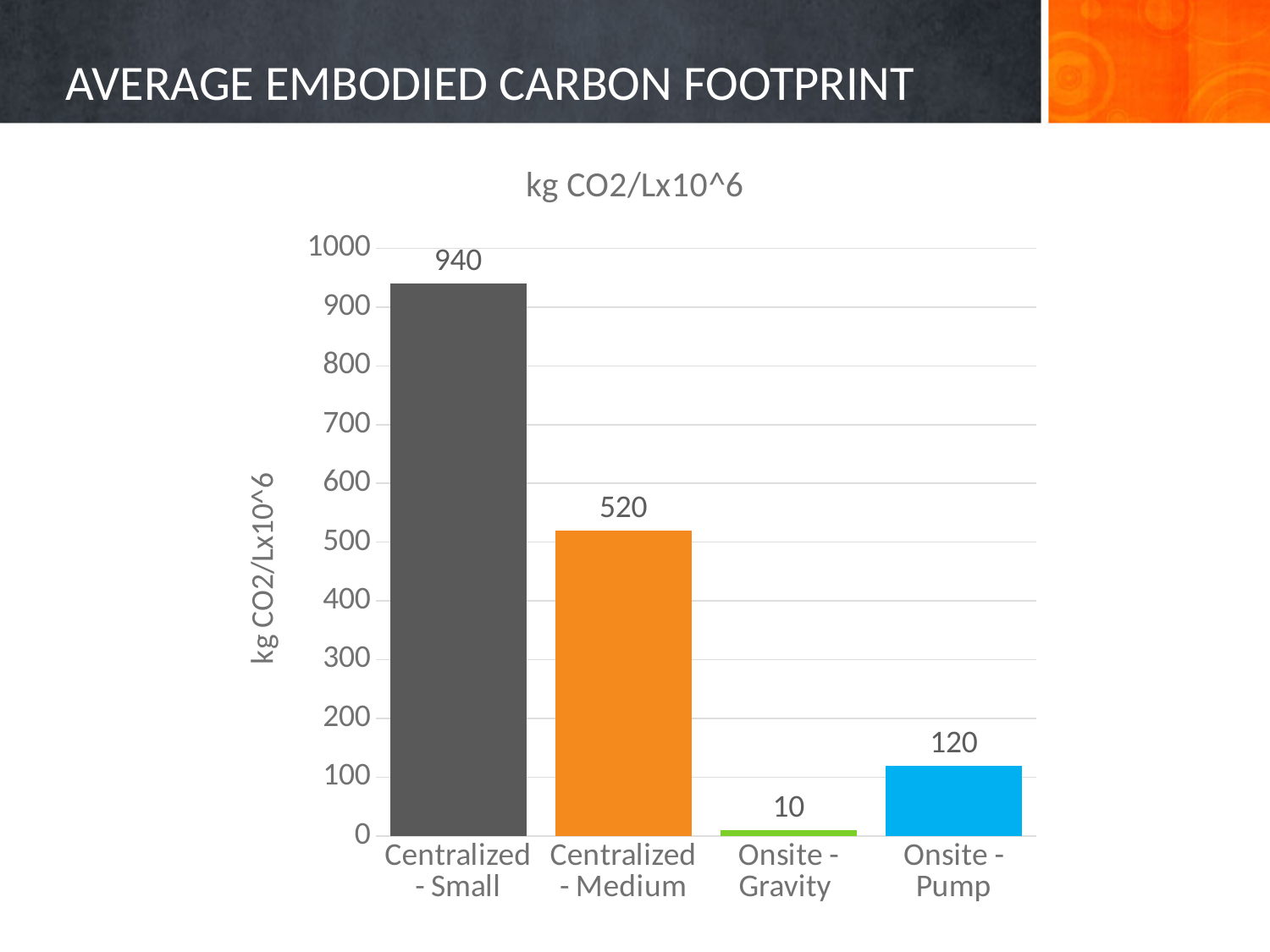
What is the value for Onsite - Pump? 120 What is the difference between the values for Onsite - Pump and Onsite - Gravity? 110 How many categories are shown in the chart? 4 Which is larger, the value for Centralized - Medium or the value for Onsite - Pump? Centralized - Medium What kind of chart is shown on the slide? Bar chart Which category has the lowest value? Onsite - Gravity What is the value for Onsite - Gravity? 10 What is the difference between the values for Centralized - Small and Centralized - Medium? 420 Which category has the highest value? Centralized - Small What is the value for Centralized - Small? 940 What is the value for Centralized - Medium? 520 What is the title of the chart? kg CO2/Lx10^6